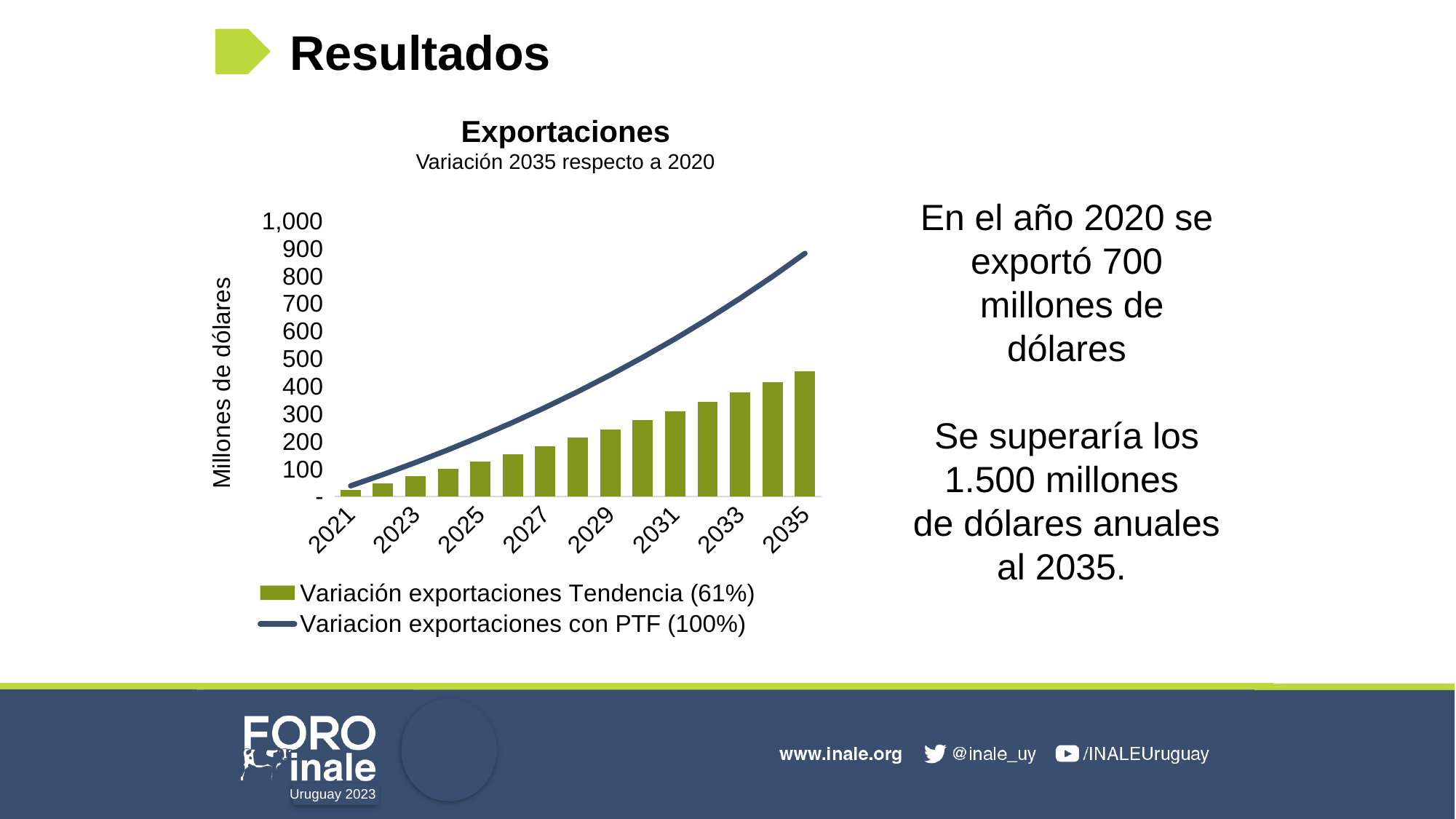
Is the value of the Variacion exportaciones con PTF (100%) line in 2031 greater or less than 500? greater Is the value of the Variación exportaciones Tendencia (61%) bar for 2021 greater or less than 100? less Do the values of the Variación exportaciones Tendencia (61%) bars rise or fall from 2021 to 2035? rise Which year has the tallest bar for Variación exportaciones Tendencia (61%)? 2035 How many series does the chart legend list? 2 What is the label of the vertical axis? Millones de dólares Which year has the shortest bar for Variación exportaciones Tendencia (61%)? 2021 In 2035, which is larger: the Variacion exportaciones con PTF (100%) line or the Variación exportaciones Tendencia (61%) bar? Variacion exportaciones con PTF (100%) How many bars are plotted in the chart? 15 Is the value of the Variacion exportaciones con PTF (100%) line in 2035 greater or less than 800? greater What is the title of the chart? Exportaciones